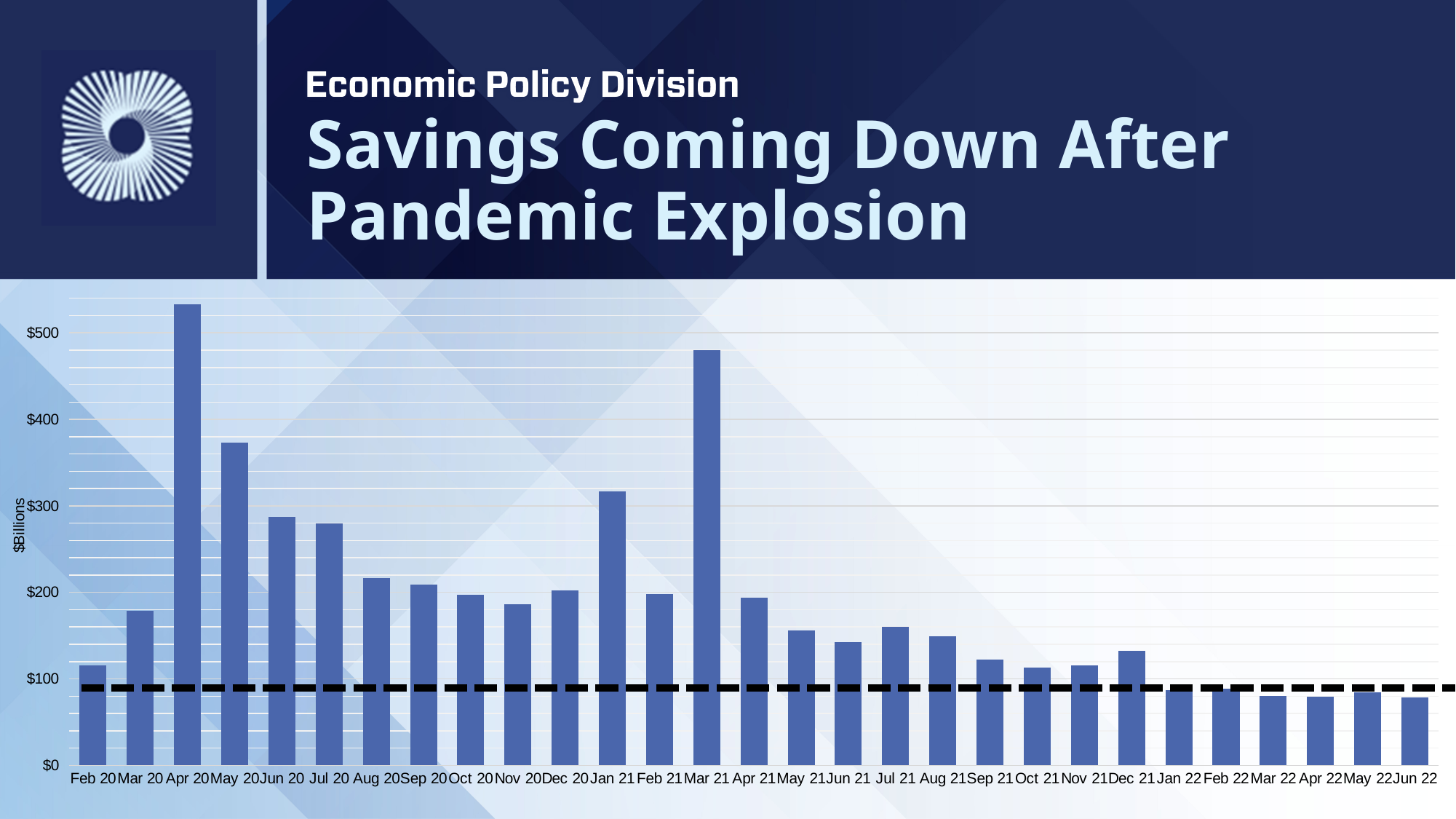
Which is larger, the value for Apr 20 or the value for Mar 21? Apr 20 Is the value for Apr 20 greater or less than $500? greater Is the value for Jan 21 greater or less than $300? greater Is the value for May 20 greater or less than $400? less What kind of chart is shown on the slide? Bar chart What is the label on the vertical axis of the chart? $Billions Which is larger, the value for Jan 21 or the value for Dec 20? Jan 21 How many months (bars) are plotted in the chart? 29 From Mar 21 to Jun 22, do the values generally rise or fall? Fall Which month has the highest value in the chart? Apr 20